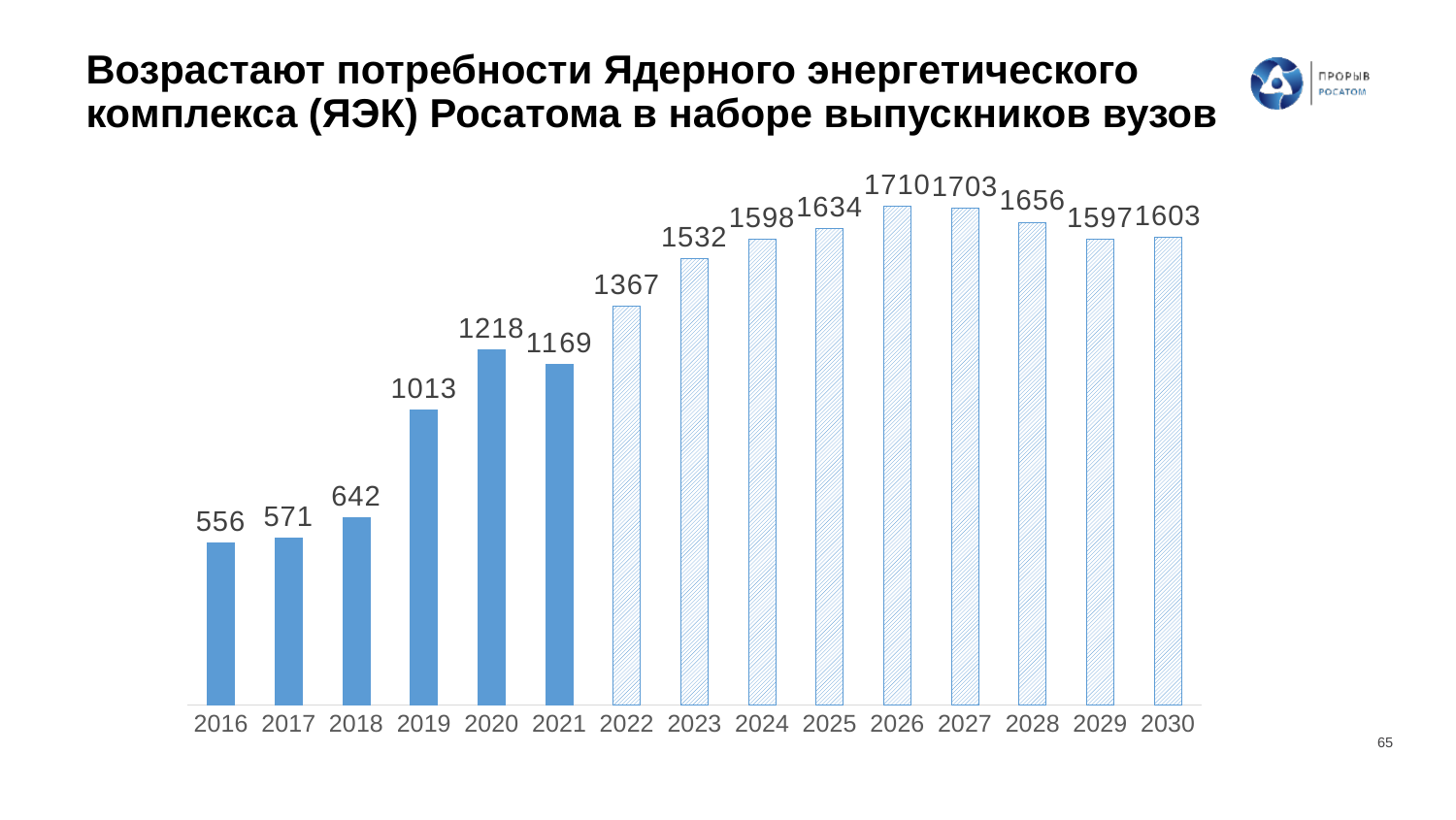
Which year has the lowest value? 2016 Which year has the highest value? 2026 What is the value for 2020? 1218 What kind of chart is shown on the slide? Bar chart How many years are shown on the x axis? 15 Which is larger, the value for 2019 or the value for 2022? 2022 What is the difference between the values for 2021 and 2020? 49 What is the difference between the values for 2026 and 2016? 1154 What is the value for 2016? 556 Do the values generally rise or fall from 2016 to 2026? Rise What is the value for 2026? 1710 What is the value for 2030? 1603